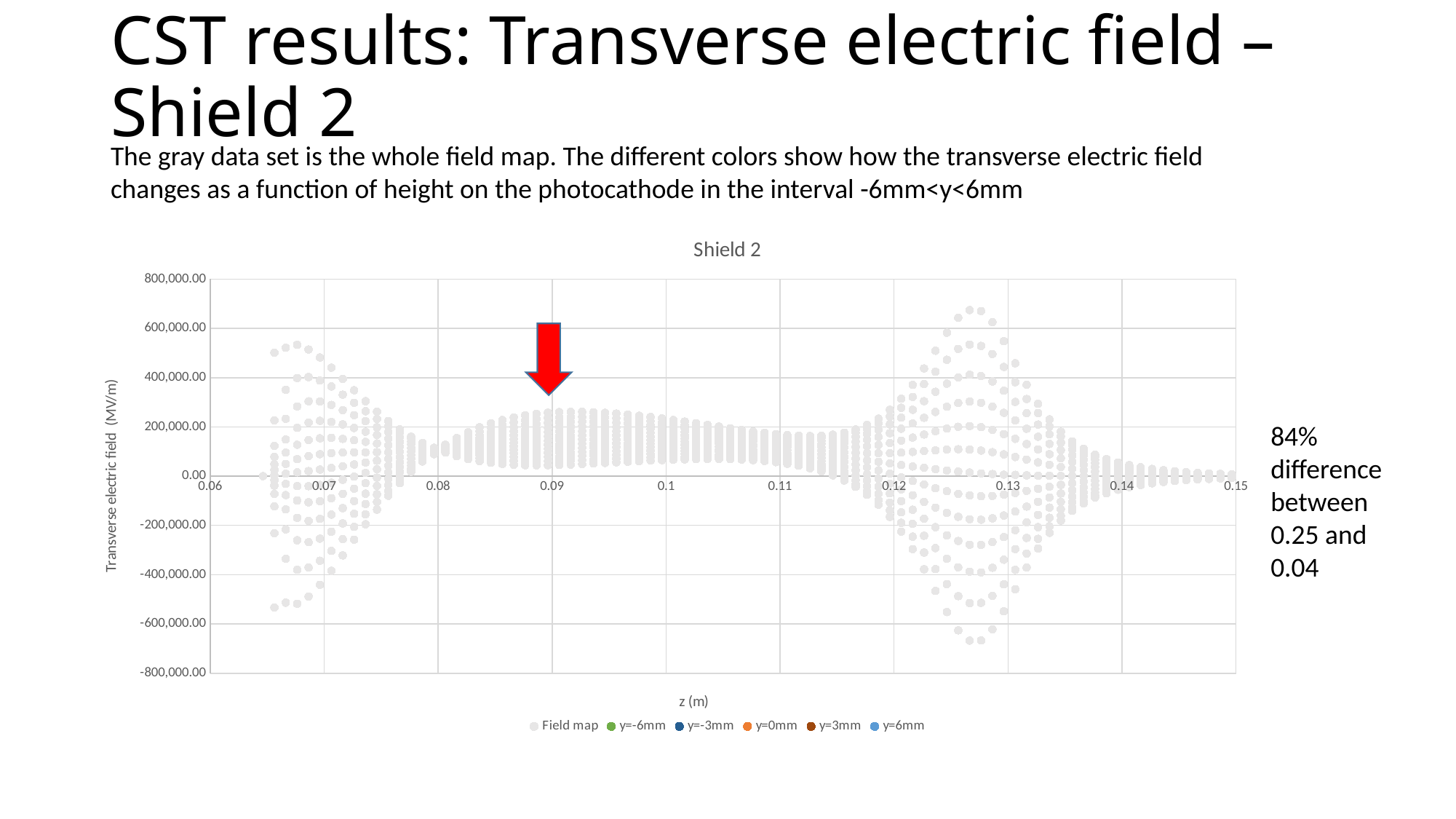
Is the highest field map value near z = 0.09 (where the red arrow points) greater or less than 400,000.00? less Is the highest field map value near z = 0.07 greater or less than 400,000.00? greater Which series in the legend is plotted in gray? Field map Are the field map values near z = 0.15 greater or less than 200,000.00? less What kind of chart is shown on the slide? scatter chart How many series does the legend of the Shield 2 chart list? 6 What is the title of the chart? Shield 2 Which region has the larger peak field map value: around z = 0.07 or around z = 0.13? around z = 0.13